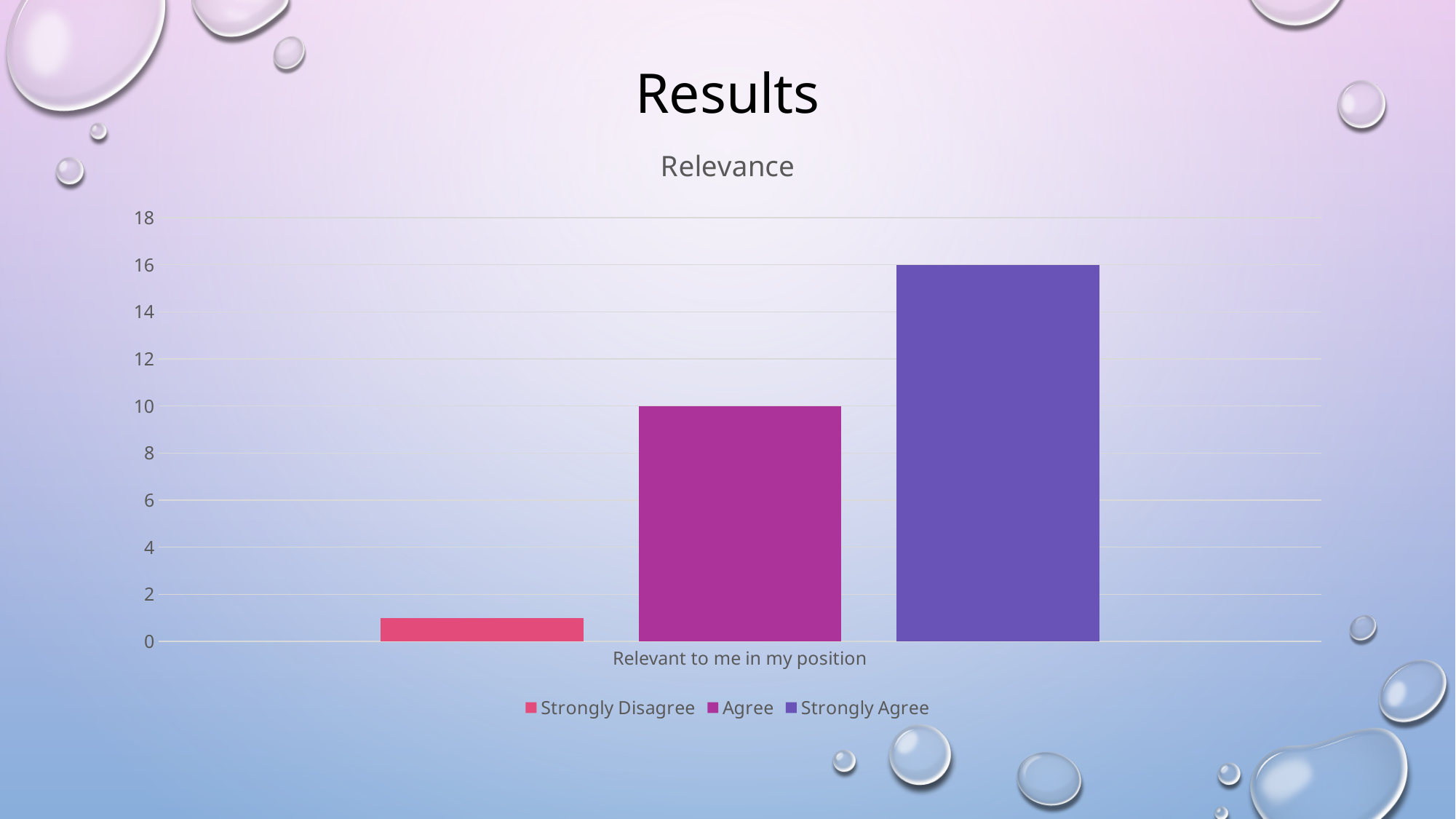
What is the difference between the Strongly Agree and Agree values? 6 What kind of chart is shown on the slide? bar chart What is the category label shown on the x axis? Relevant to me in my position Which series has the lowest value for 'Relevant to me in my position'? Strongly Disagree How many series does the legend list? 3 What is the value for Agree? 10 Is the value for Strongly Disagree greater or less than 2? less What is the value for Strongly Agree? 16 Is the value for Strongly Agree greater or less than 14? greater What is the title of the chart? Relevance Which series has the highest value for 'Relevant to me in my position'? Strongly Agree Which is larger, the value for Agree or the value for Strongly Disagree? Agree